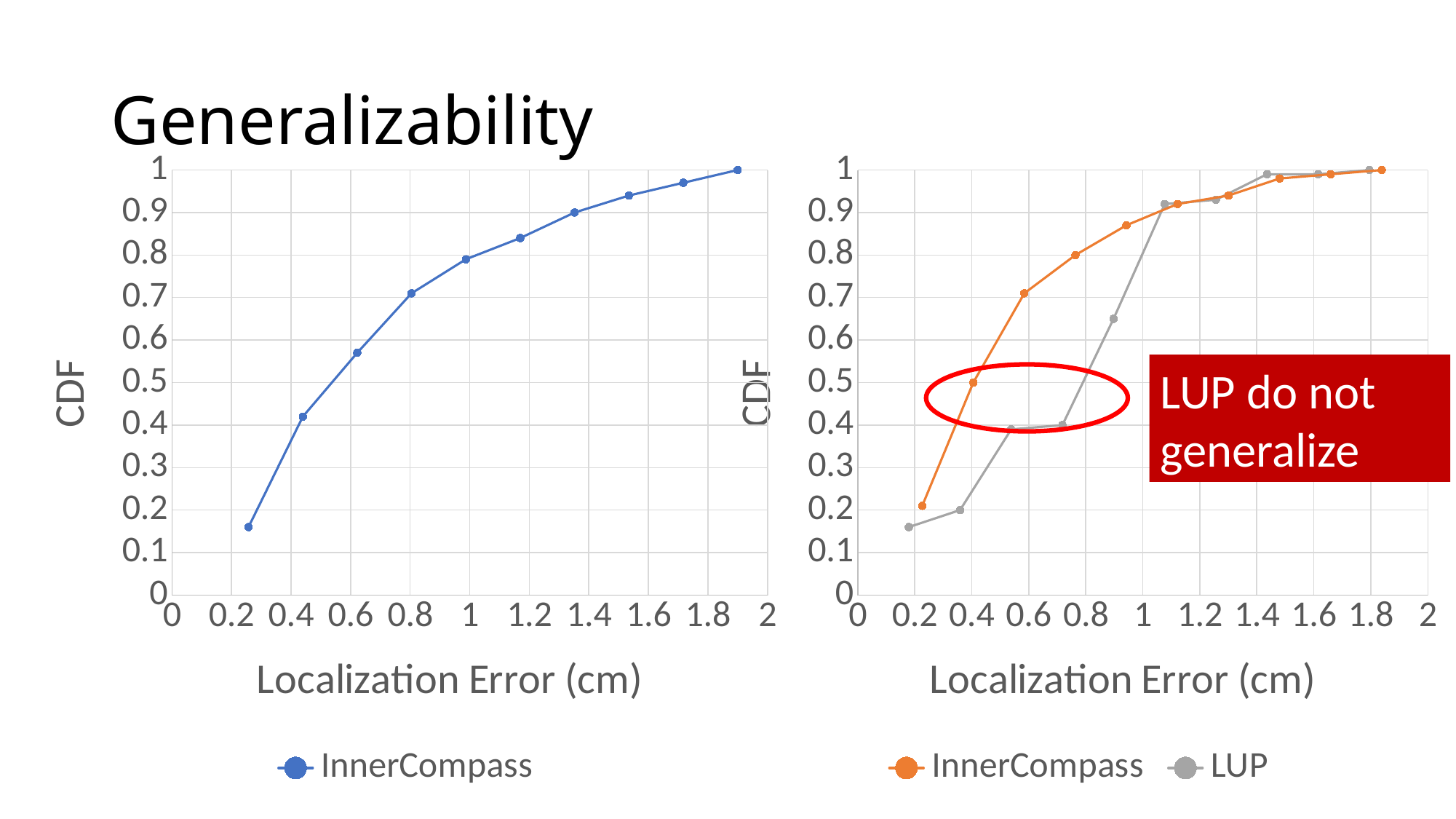
How many series does the legend of the right chart list? 2 In the left chart, what CDF value does the InnerCompass curve reach at its last point? 1 In the left chart, is the CDF value of the first InnerCompass point greater or less than 0.2? less In the right chart, does the LUP series rise or fall as Localization Error increases? rise In the right chart, is the LUP CDF value at a localization error of about 0.9 cm greater or less than 0.5? greater What is the x-axis label of the left chart? Localization Error (cm) What kind of chart is the left chart on the slide? line chart In the left chart, does the CDF rise or fall as Localization Error increases? rise How many data points are plotted for InnerCompass in the left chart? 10 In the right chart, what are the names of the two series in the legend? InnerCompass and LUP How many series does the legend of the left chart list? 1 In the right chart, at a localization error of about 0.6 cm, which series has the higher CDF, InnerCompass or LUP? InnerCompass